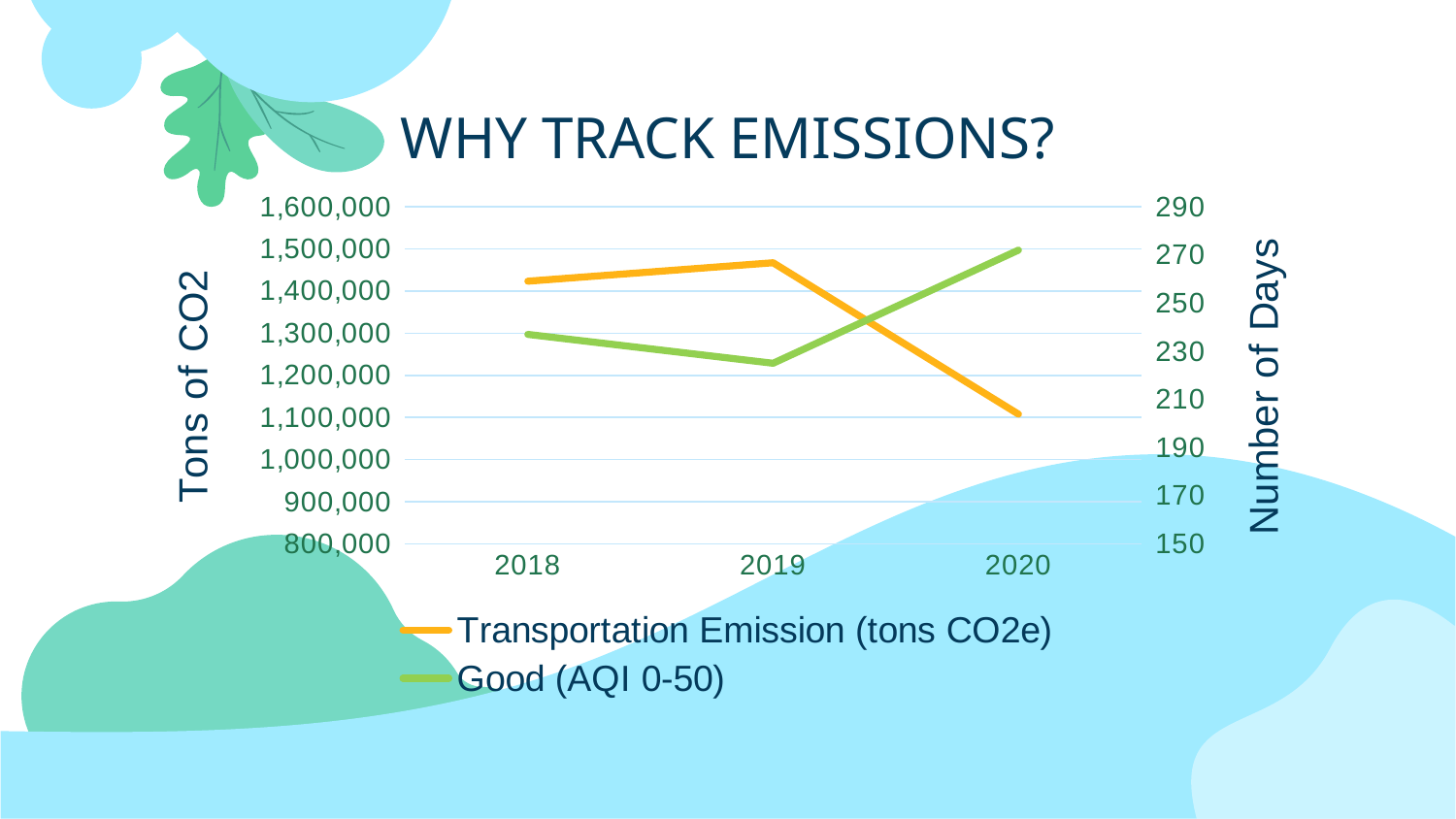
Is the Transportation Emission value for 2020 greater or less than 1,200,000? less In which year is the number of Good (AQI 0-50) days highest? 2020 How many years are plotted along the x axis? 3 How many series does the legend list? 2 In which year is Transportation Emission (tons CO2e) lowest? 2020 Does Transportation Emission rise or fall from 2019 to 2020? Fall In which year is the number of Good (AQI 0-50) days lowest? 2019 In which year is Transportation Emission (tons CO2e) highest? 2019 Is the number of Good (AQI 0-50) days in 2020 greater or less than 250? greater Is the Transportation Emission value for 2019 greater or less than 1,400,000? greater What is the title of the left vertical axis? Tons of CO2 What kind of chart is shown on the slide? Line chart